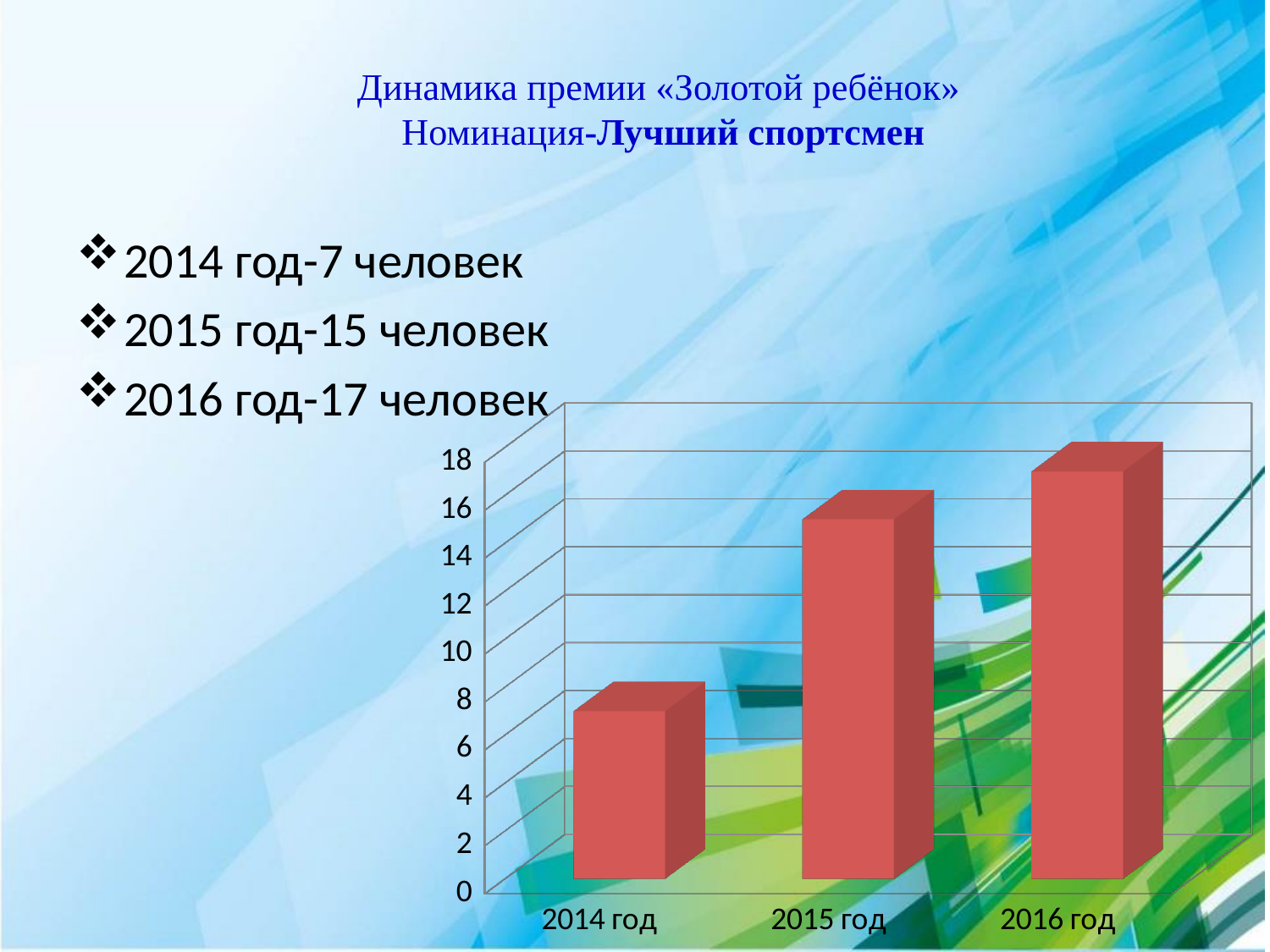
According to the slide, what is the value for 2016 год? 17 человек What kind of chart is shown on the slide? bar chart How many bars (categories) does the chart show? 3 Which year has the highest bar in the chart? 2016 год Which is larger, the value for 2015 год or the value for 2014 год? 2015 год Is the value for 2014 год greater or less than 10? less According to the slide, what is the value for 2014 год? 7 человек What is the difference between the values for 2015 год and 2014 год, using the numbers printed on the slide? 8 Is the value for 2016 год greater or less than 16? greater Which year has the lowest bar in the chart? 2014 год Do the values rise or fall from 2014 год to 2016 год? rise According to the slide, what is the value for 2015 год? 15 человек